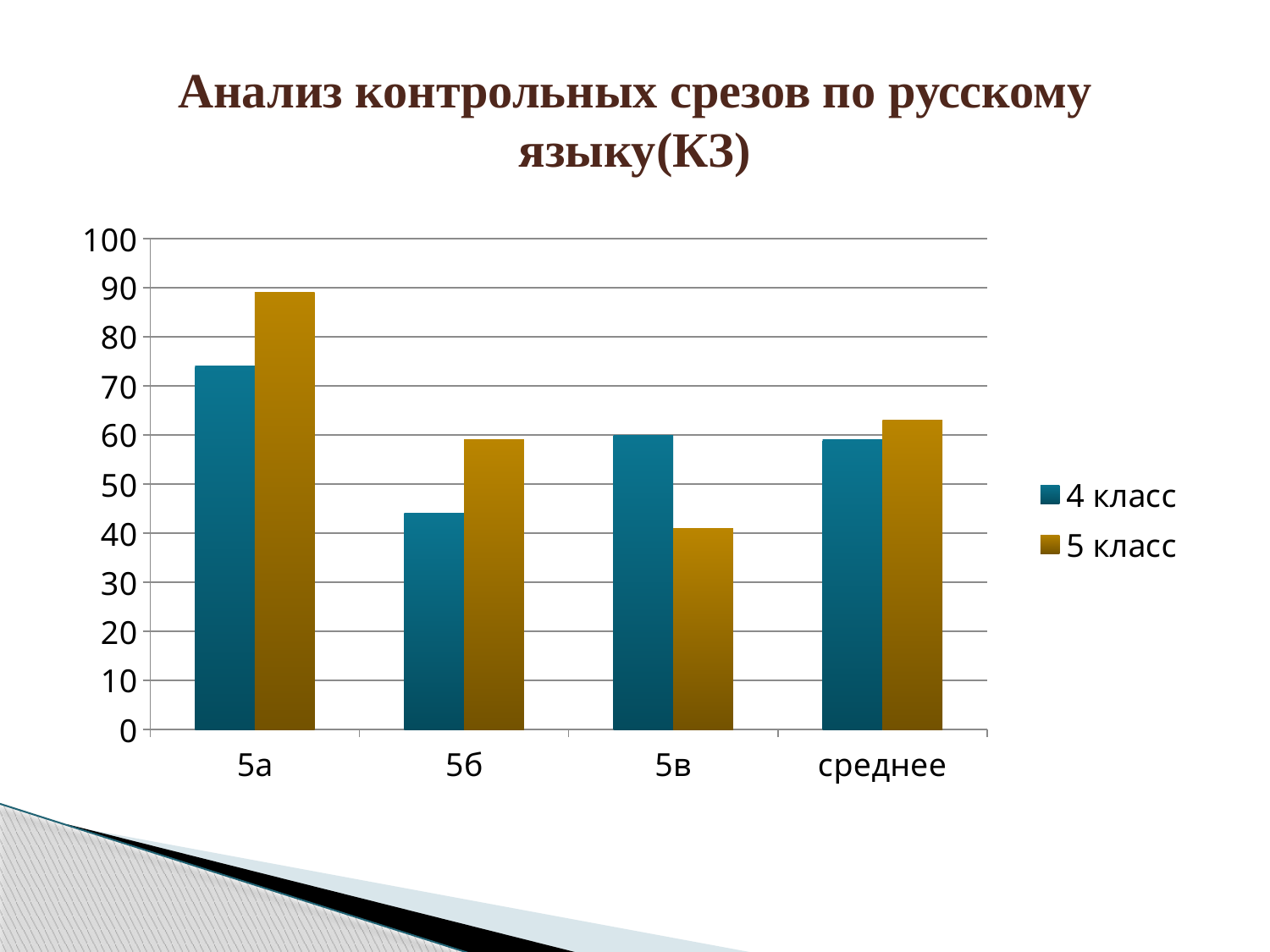
Is the value for 4 класс in 5б greater or less than 50? less For 5в, which is larger: the value for 4 класс or for 5 класс? 4 класс What kind of chart is shown on the slide? bar chart Is the value for 5 класс in 5а greater or less than 80? greater Which category has the lowest value for 5 класс? 5в How many categories are shown on the x axis? 4 What are the two series named in the legend? 4 класс and 5 класс How many series does the legend list? 2 Which category has the highest value for 5 класс? 5а Which category has the lowest value for 4 класс? 5б Which category has the highest value for 4 класс? 5а Is the value for 5 класс in 5в greater or less than 50? less